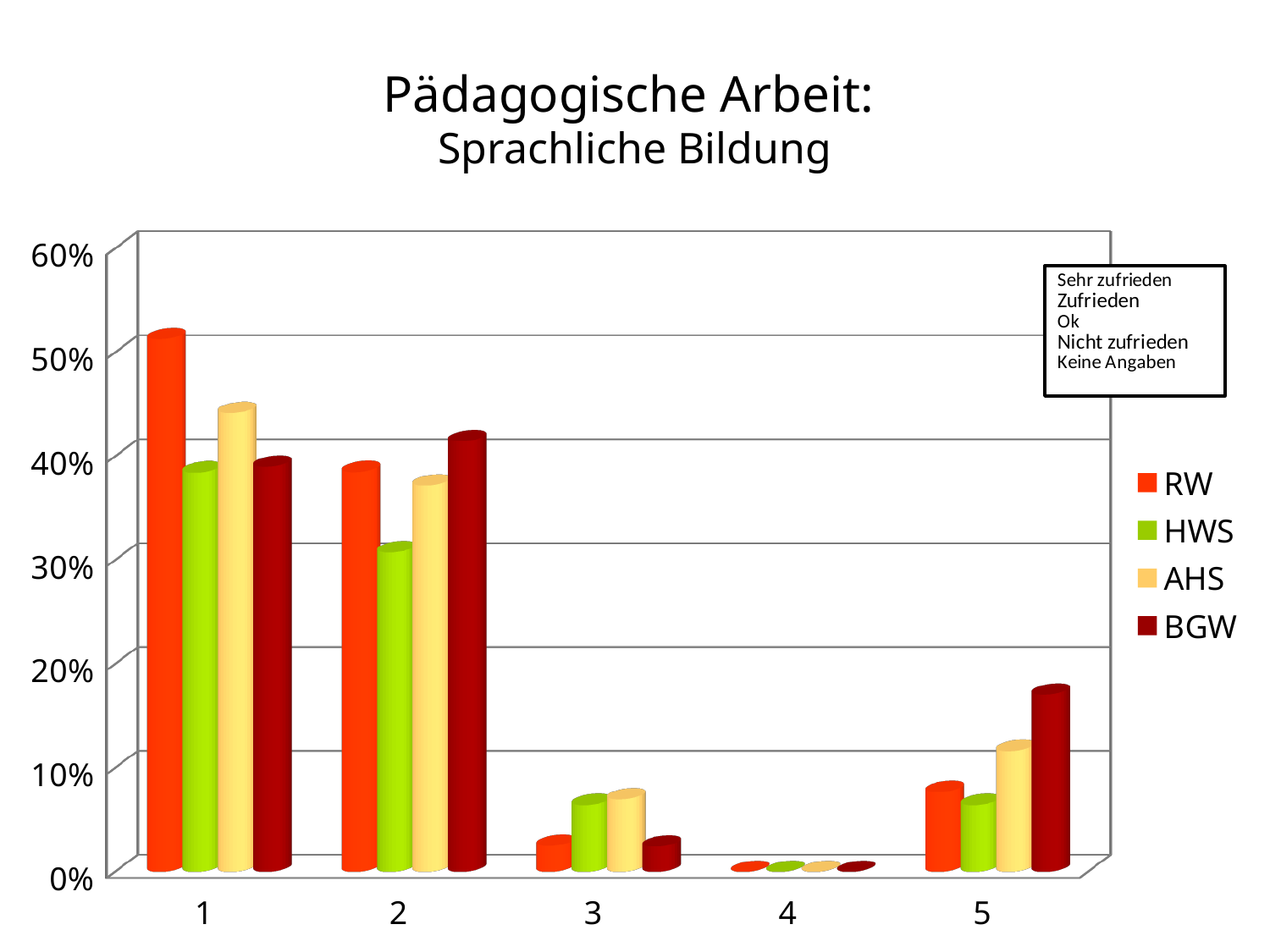
Which series has the highest value in category 5? BGW Is the value for BGW in category 5 greater or less than 10%? greater How many series does the legend list? 4 What kind of chart is shown on the slide? bar chart Which is larger, the RW value in category 1 or the RW value in category 2? RW in category 1 Which series has the lowest value in category 2? HWS How many categories are shown on the x axis? 5 Is the value for RW in category 1 greater or less than 50%? greater Is the value for HWS in category 2 greater or less than 40%? less Which category has the lowest values across all series? 4 What is the title of the chart? Pädagogische Arbeit: Sprachliche Bildung Which series has the highest value in category 1? RW